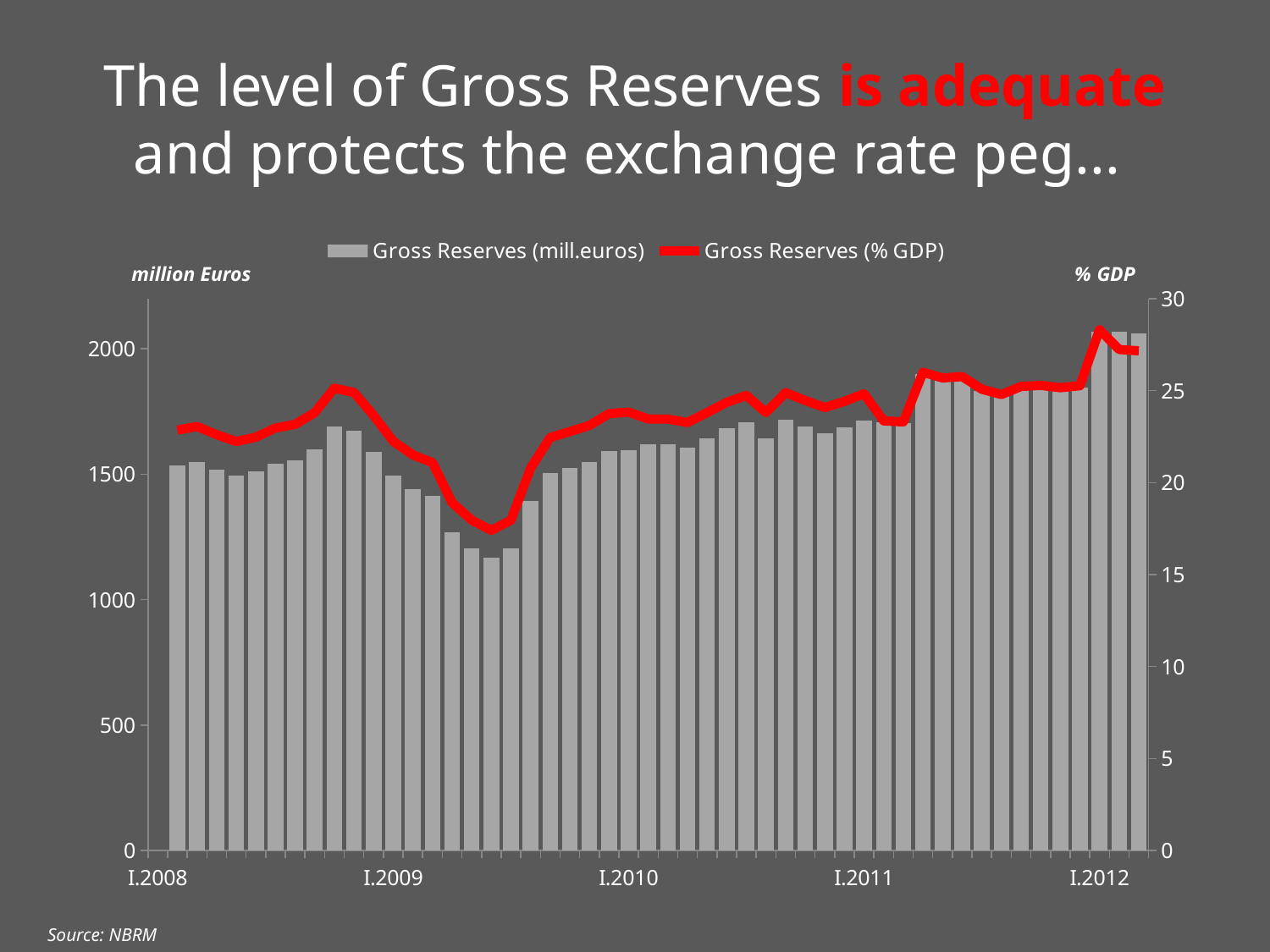
Which series is drawn as a red line? Gross Reserves (% GDP) What is the label of the left vertical axis? million Euros In which year does the lowest Gross Reserves (mill.euros) bar occur? 2009 Is the lowest point of the Gross Reserves (% GDP) line greater or less than 20? less Do the Gross Reserves (mill.euros) bars rise or fall between I.2011 and I.2012? rise What kind of chart is shown on the slide? Combined bar and line chart How many series does the legend list? 2 Does the Gross Reserves (% GDP) line rise or fall between I.2009 and the middle of 2009? fall Is the Gross Reserves (% GDP) value at I.2009 greater or less than 20? greater Is the lowest Gross Reserves (mill.euros) bar greater or less than 1500? less